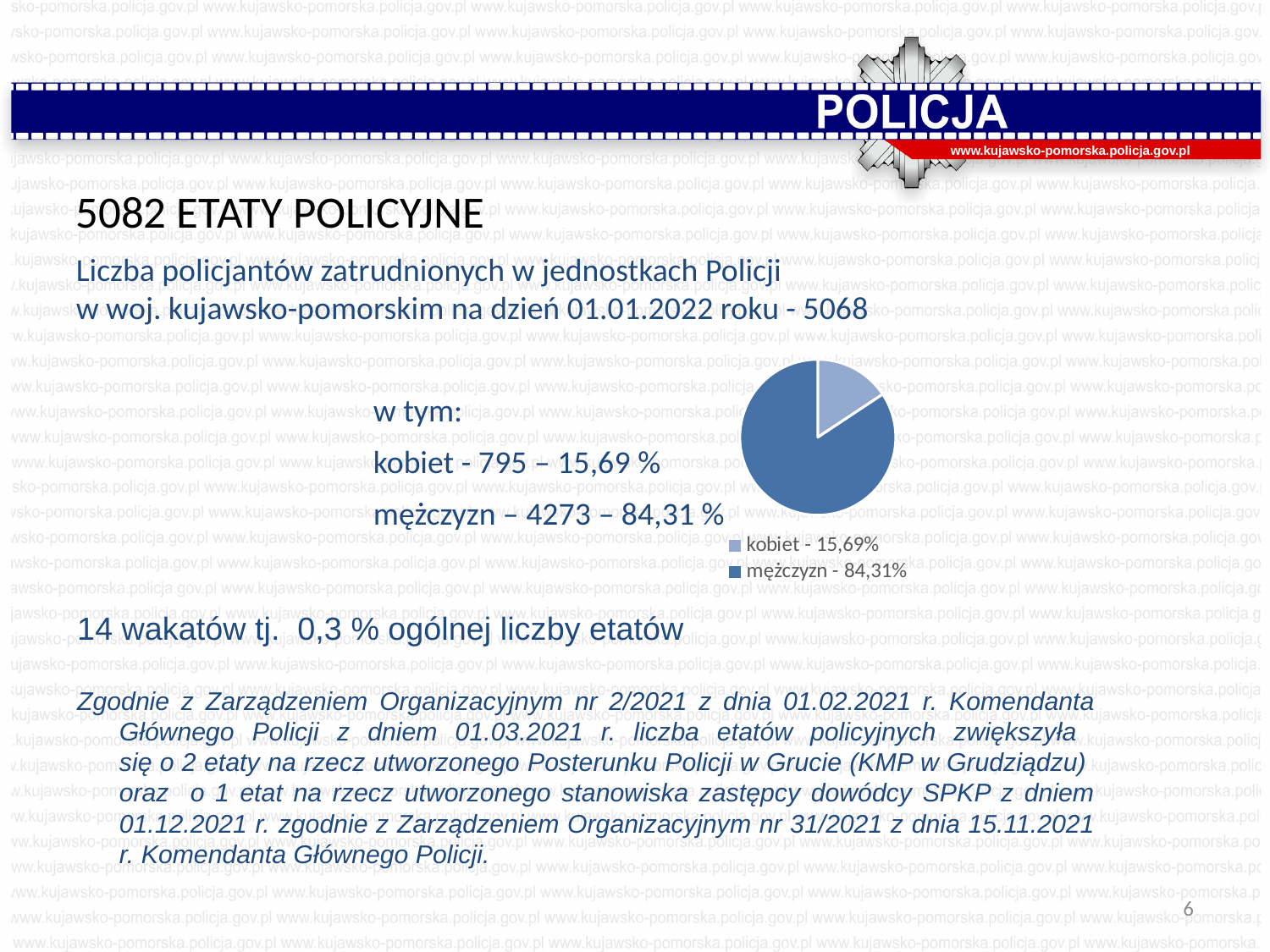
How many entries does the legend of the pie chart list? 2 Which is larger in the pie chart, the 'kobiet' slice or the 'mężczyzn' slice? mężczyzn How many slices does the pie chart have? 2 What is the legend label of the lighter blue slice in the pie chart? kobiet - 15,69% What kind of chart is shown on the slide? pie chart What colour is the 'mężczyzn' slice in the pie chart? dark blue What share of the pie does the 'mężczyzn' slice represent? 84,31% Is the share of the 'kobiet' slice greater or less than 50%? less Which slice of the pie chart is the smallest? kobiet What share of the pie does the 'kobiet' slice represent? 15,69% Which slice of the pie chart is the largest? mężczyzn What is the difference in percentage points between the 'mężczyzn' and 'kobiet' shares in the pie chart? 68,62